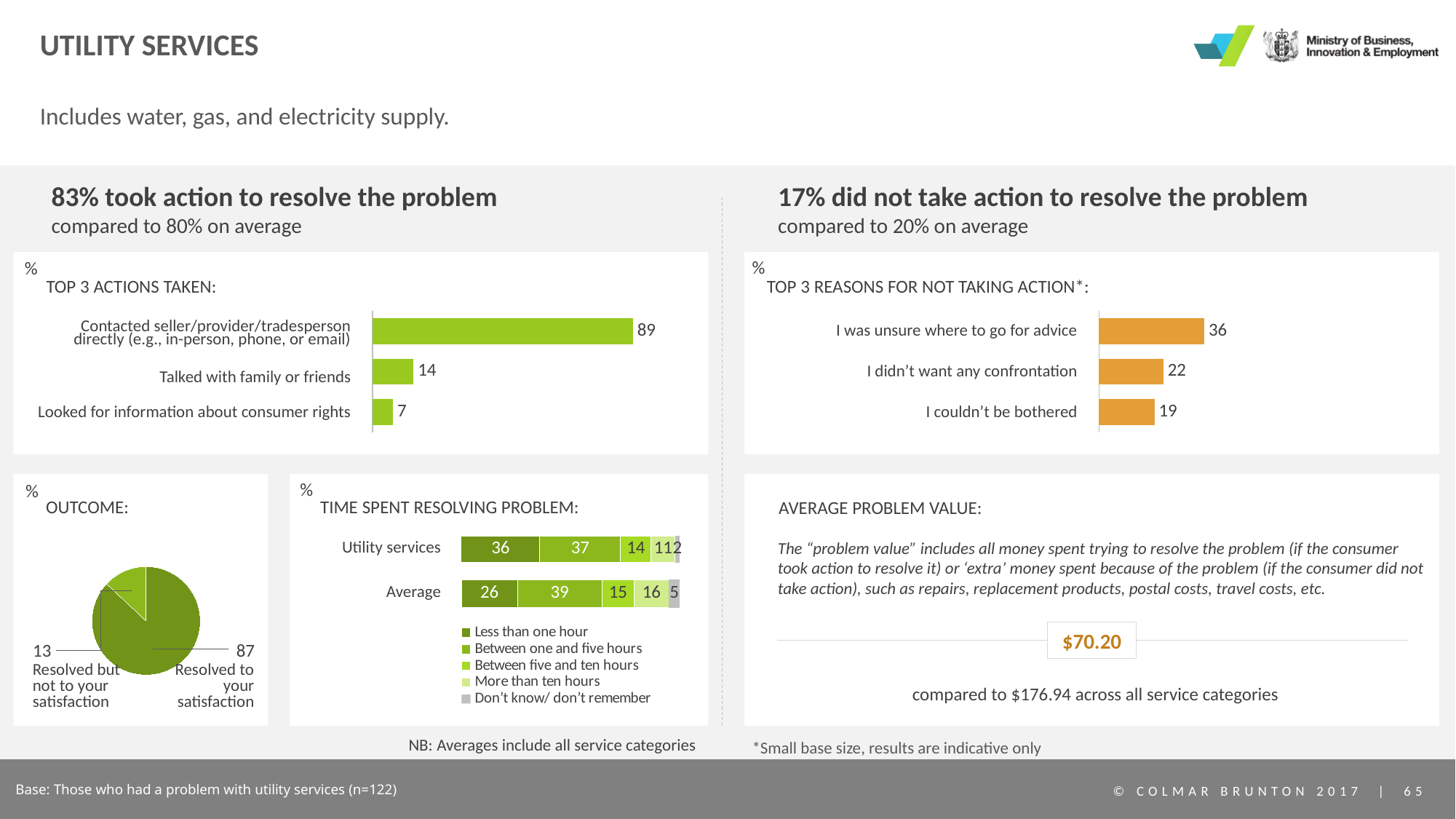
In the 'Time spent resolving problem' chart, what is the value for 'Between one and five hours' for Average? 39 In the 'Top 3 reasons for not taking action' chart, which is larger: 'I didn't want any confrontation' or 'I couldn't be bothered'? I didn't want any confrontation In the 'Top 3 actions taken' chart, what percentage contacted the seller/provider/tradesperson directly? 89 In the 'Top 3 reasons for not taking action' chart, what is the value for 'I couldn't be bothered'? 19 How many series does the legend of the 'Time spent resolving problem' chart list? 5 In the 'Top 3 actions taken' chart, what is the difference between 'Contacted seller/provider/tradesperson directly' and 'Talked with family or friends'? 75 In the 'Outcome' pie chart, what percentage was resolved to your satisfaction? 87 What kind of chart is the 'Outcome' chart? Pie chart In the 'Top 3 reasons for not taking action' chart, which reason has the highest value? I was unsure where to go for advice In the 'Top 3 actions taken' chart, what is the value for 'Looked for information about consumer rights'? 7 In the 'Top 3 reasons for not taking action' chart, how many reasons are shown? 3 In the 'Time spent resolving problem' chart, what is the value for 'Less than one hour' for Utility services? 36